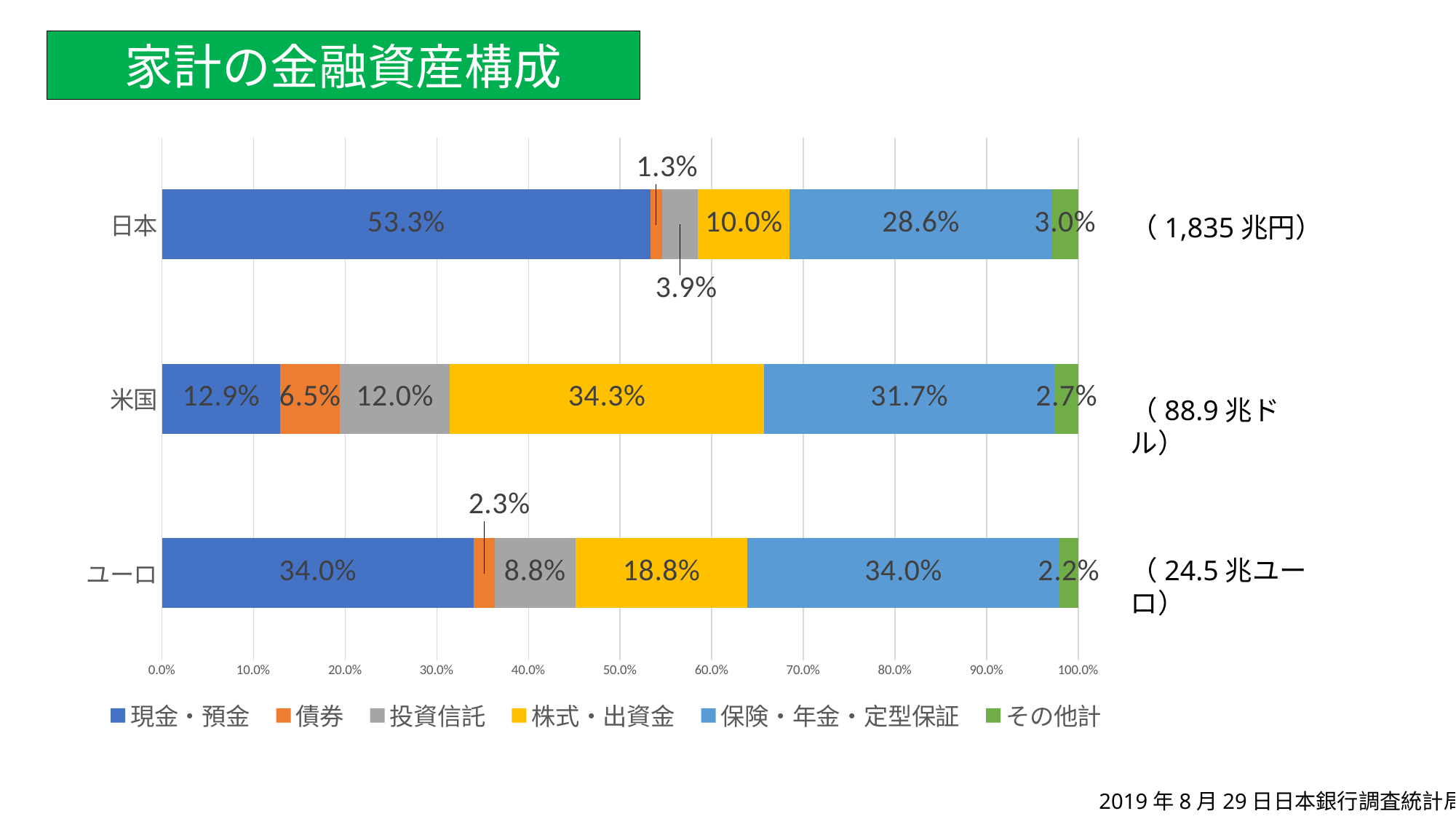
What kind of chart is shown on the slide? Stacked bar chart What is the title of the slide? 家計の金融資産構成 Which is larger, the 株式・出資金 value for ユーロ or for 日本? ユーロ How many series does the legend list? 6 How many categories (bars) are shown on the chart? 3 What is the difference between the 保険・年金・定型保証 values for 米国 and 日本? 3.1% What is the value for 現金・預金 in the 日本 bar? 53.3% What is the value for 株式・出資金 in the 米国 bar? 34.3% What is the value for 投資信託 in the ユーロ bar? 8.8% What is the value for 債券 in the 日本 bar? 1.3% Which category has the highest 現金・預金 share? 日本 Which category has the lowest その他計 share? ユーロ